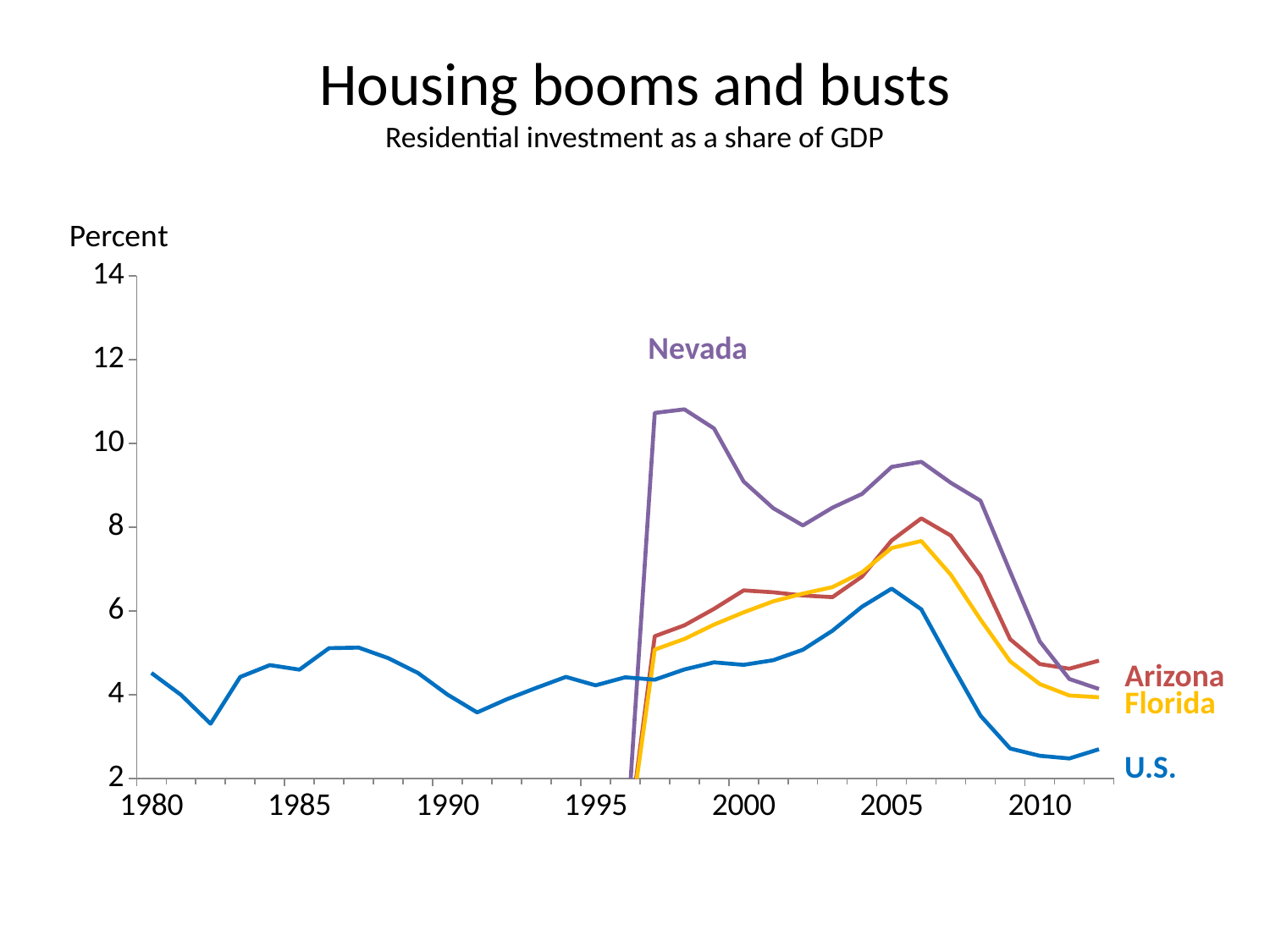
Is the value for Nevada in 1998 greater or less than 10? greater Is the value for Florida in 2005 greater or less than 6? greater How many series are plotted on the chart? 4 What is the title of the chart? Housing booms and busts Does the U.S. series rise or fall between 2005 and 2010? fall What is the label on the vertical axis? Percent Which is larger in 2005, the value for Nevada or the value for U.S.? Nevada What kind of chart is shown on the slide? line chart Which series reaches the highest value on the chart? Nevada How many year labels are shown on the horizontal axis? 7 Which series has the lowest value in 2010? U.S. Is the value for U.S. in 2010 greater or less than 4? less